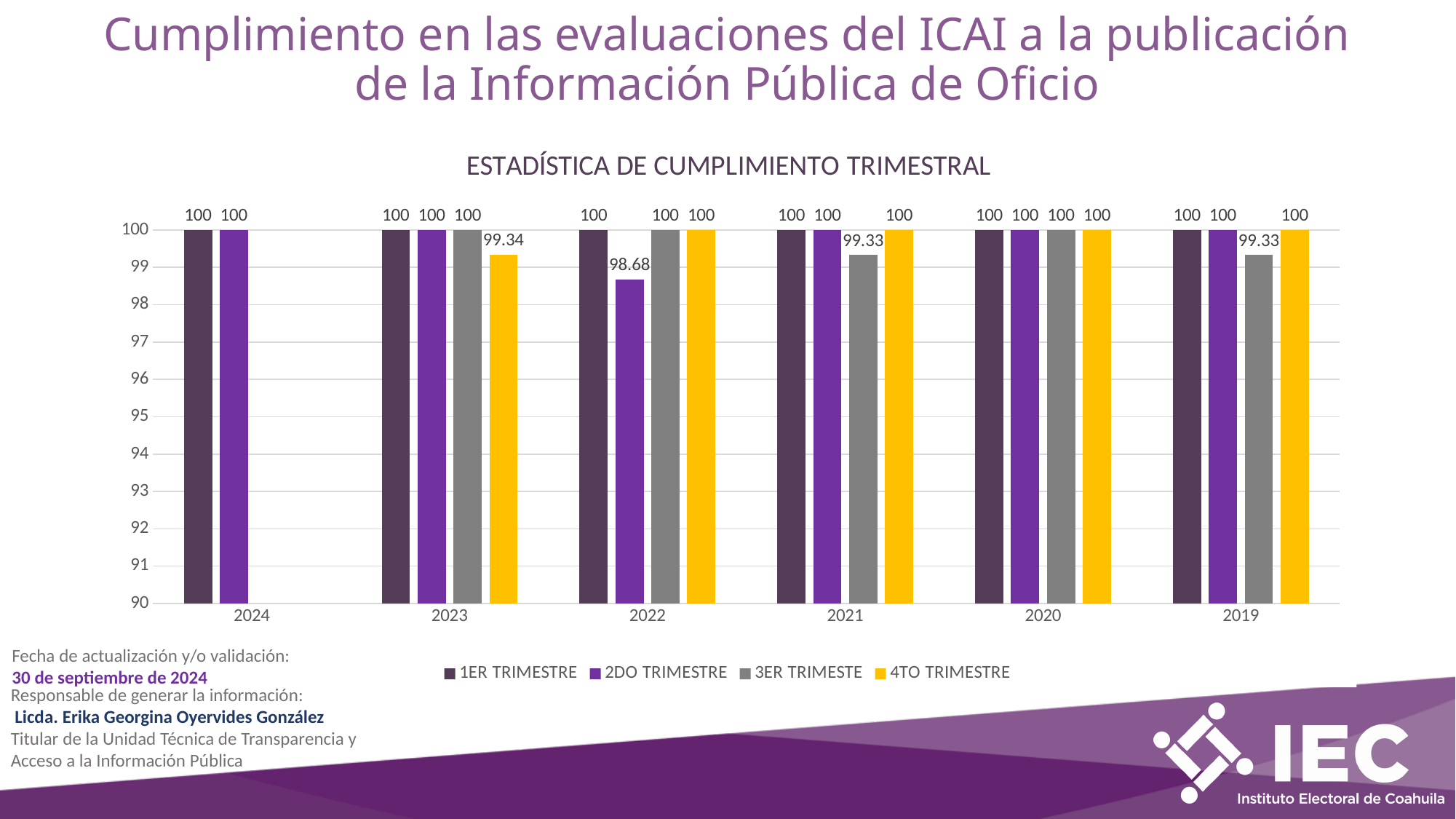
What is the difference between the 1ER TRIMESTRE value and the 2DO TRIMESTRE value in 2022? 1.32 What type of chart is shown on the slide? bar chart What is the value for 1ER TRIMESTRE in 2020? 100 What is the value for 2DO TRIMESTRE in 2022? 98.68 How many years are shown on the x axis? 6 What is the title of the chart? ESTADÍSTICA DE CUMPLIMIENTO TRIMESTRAL How many bars are plotted for 2024? 2 Which year has the lowest single bar value in the chart? 2022 What is the value for 4TO TRIMESTRE in 2023? 99.34 How many series does the legend list? 4 What is the value for 3ER TRIMESTE in 2021? 99.33 Which is larger in 2023: the 3ER TRIMESTE value or the 4TO TRIMESTRE value? 3ER TRIMESTE